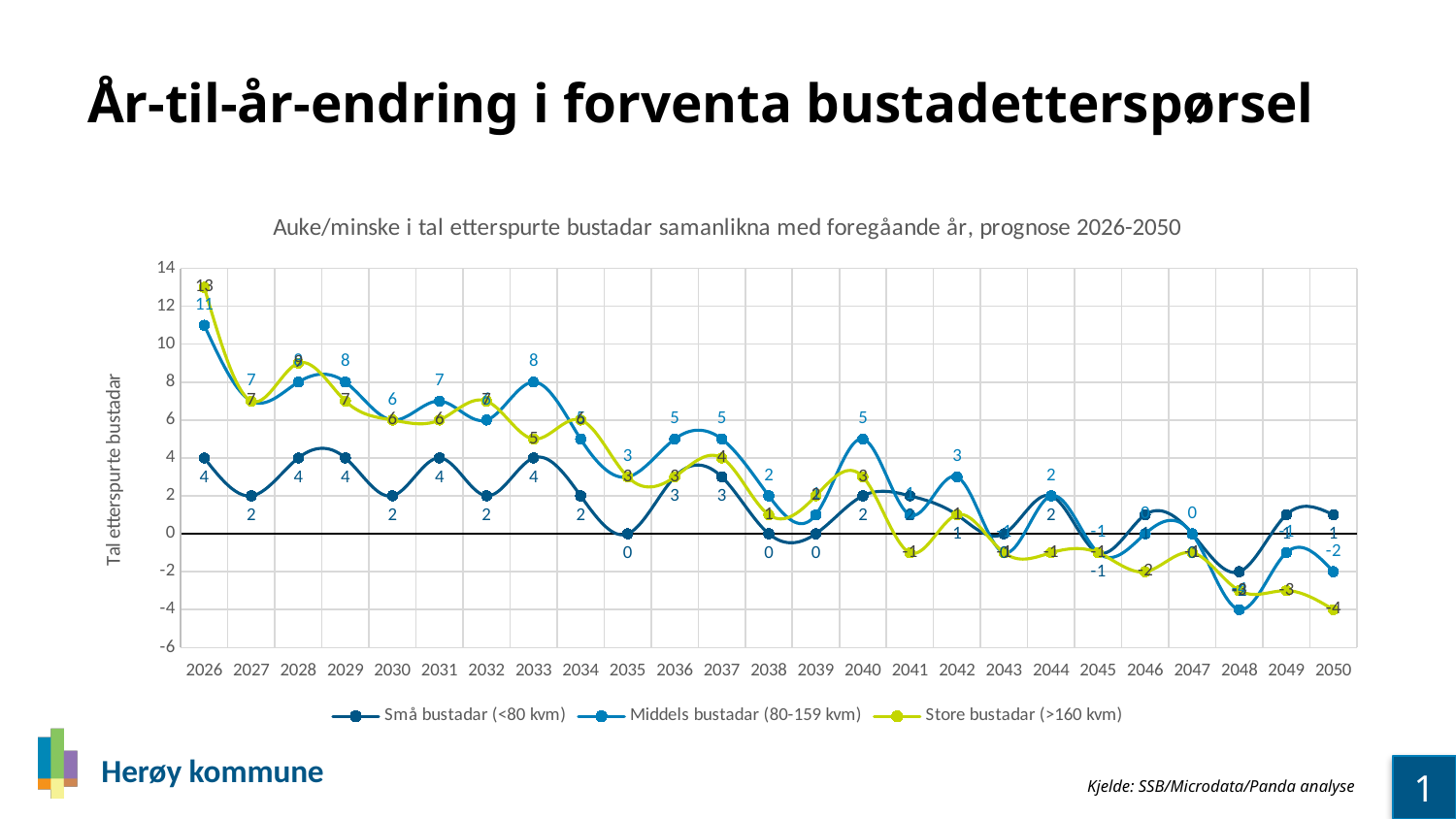
In which year does Store bustadar (>160 kvm) reach its highest value? 2026 What is the value for Middels bustadar (80-159 kvm) in 2033? 8 What is the value for Middels bustadar (80-159 kvm) in 2048? -4 How many years are plotted along the x axis? 25 How many series does the legend list? 3 What type of chart is shown on the slide? Line chart What is the value for Små bustadar (<80 kvm) in 2035? 0 Which series has the larger value in 2033, Middels bustadar (80-159 kvm) or Små bustadar (<80 kvm)? Middels bustadar (80-159 kvm) What is the value for Middels bustadar (80-159 kvm) in 2026? 11 What is the difference between Store bustadar (>160 kvm) and Middels bustadar (80-159 kvm) in 2026? 2 What is the value for Store bustadar (>160 kvm) in 2026? 13 Do the values for Middels bustadar (80-159 kvm) generally rise or fall from 2026 to 2050? Fall